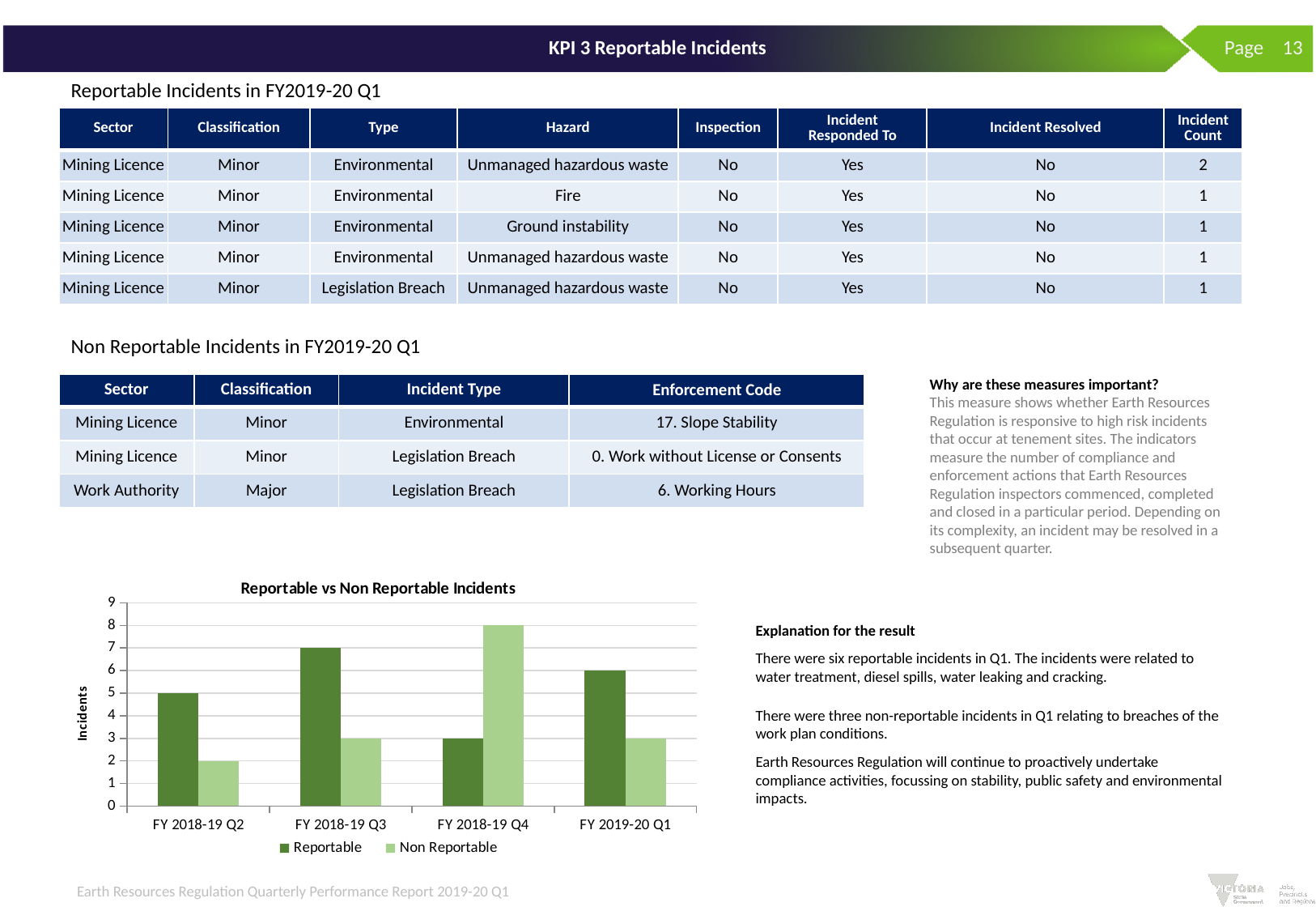
In the 'Reportable vs Non Reportable Incidents' chart, what is the Reportable value for FY 2019-20 Q1? 6 What kind of chart is 'Reportable vs Non Reportable Incidents'? bar chart In the 'Reportable vs Non Reportable Incidents' chart, which is larger for FY 2018-19 Q4: Reportable or Non Reportable? Non Reportable In the 'Reportable vs Non Reportable Incidents' chart, what is the difference between the Reportable and Non Reportable values for FY 2018-19 Q3? 4 In the 'Reportable vs Non Reportable Incidents' chart, which quarter has the highest Reportable value? FY 2018-19 Q3 In the 'Reportable vs Non Reportable Incidents' chart, which series is shown in the darker green? Reportable What is the label of the y axis in the 'Reportable vs Non Reportable Incidents' chart? Incidents In the 'Reportable vs Non Reportable Incidents' chart, is the Reportable value for FY 2018-19 Q2 greater or less than 4? greater In the 'Reportable vs Non Reportable Incidents' chart, what is the Non Reportable value for FY 2018-19 Q4? 8 How many series does the legend of the 'Reportable vs Non Reportable Incidents' chart list? 2 In the 'Reportable vs Non Reportable Incidents' chart, which quarter has the lowest Non Reportable value? FY 2018-19 Q2 How many quarters are shown on the x axis of the 'Reportable vs Non Reportable Incidents' chart? 4